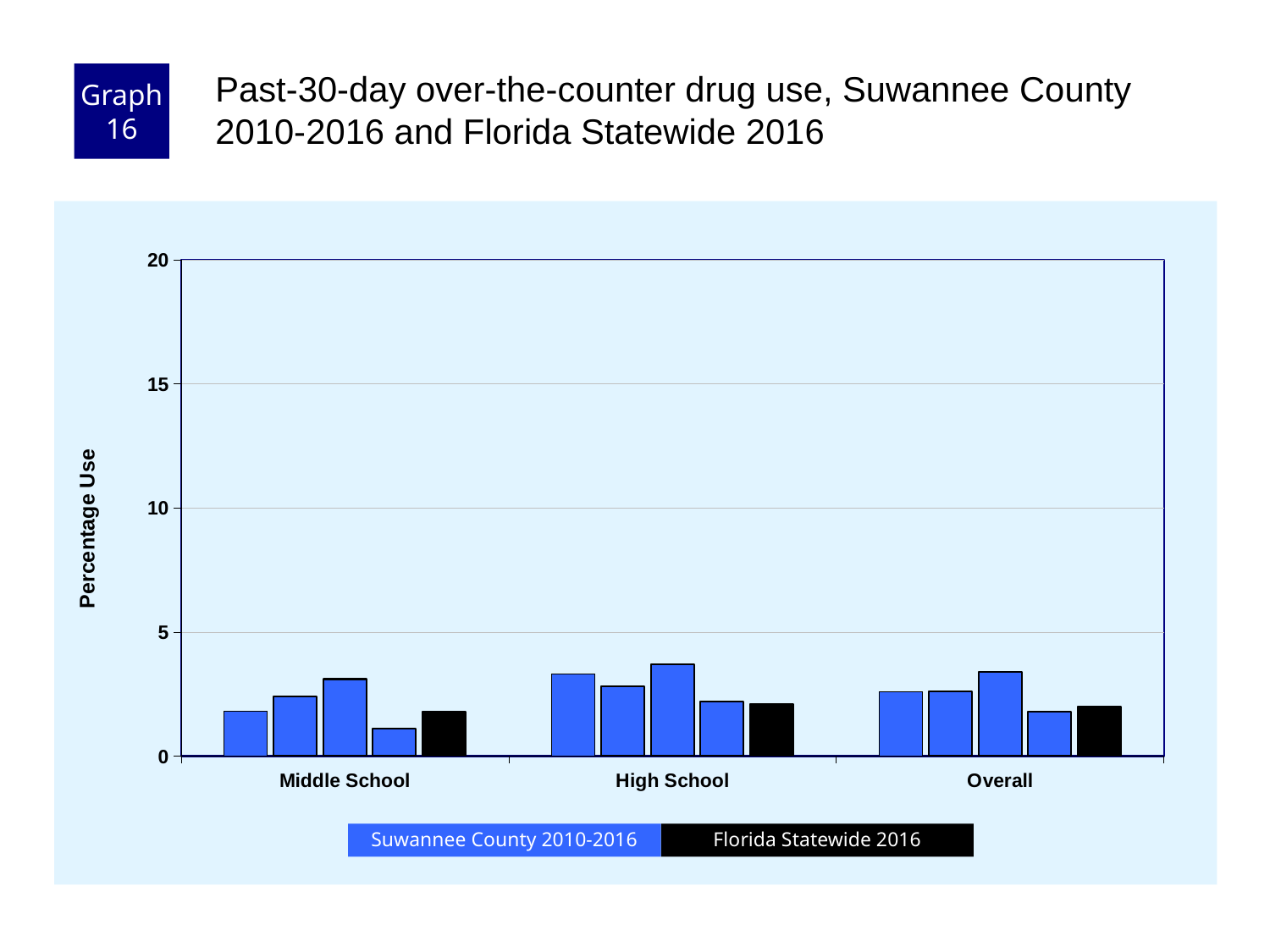
Is the tallest Suwannee County 2010-2016 bar in the High School category greater or less than 5? less In which category does the shortest bar on the chart appear? Middle School How many series does the legend list? 2 What is the title of the y axis? Percentage Use Is the value for Florida Statewide 2016 in the High School category greater or less than 5? less Which colour represents Florida Statewide 2016 in the legend? black What kind of chart is shown on the slide? bar chart Is the value for Florida Statewide 2016 in the Overall category greater or less than 5? less In the High School category, which is larger: the tallest Suwannee County 2010-2016 bar or the Florida Statewide 2016 bar? Suwannee County 2010-2016 In the Middle School category, which is larger: the shortest Suwannee County 2010-2016 bar or the Florida Statewide 2016 bar? Florida Statewide 2016 How many categories are shown on the x axis? 3